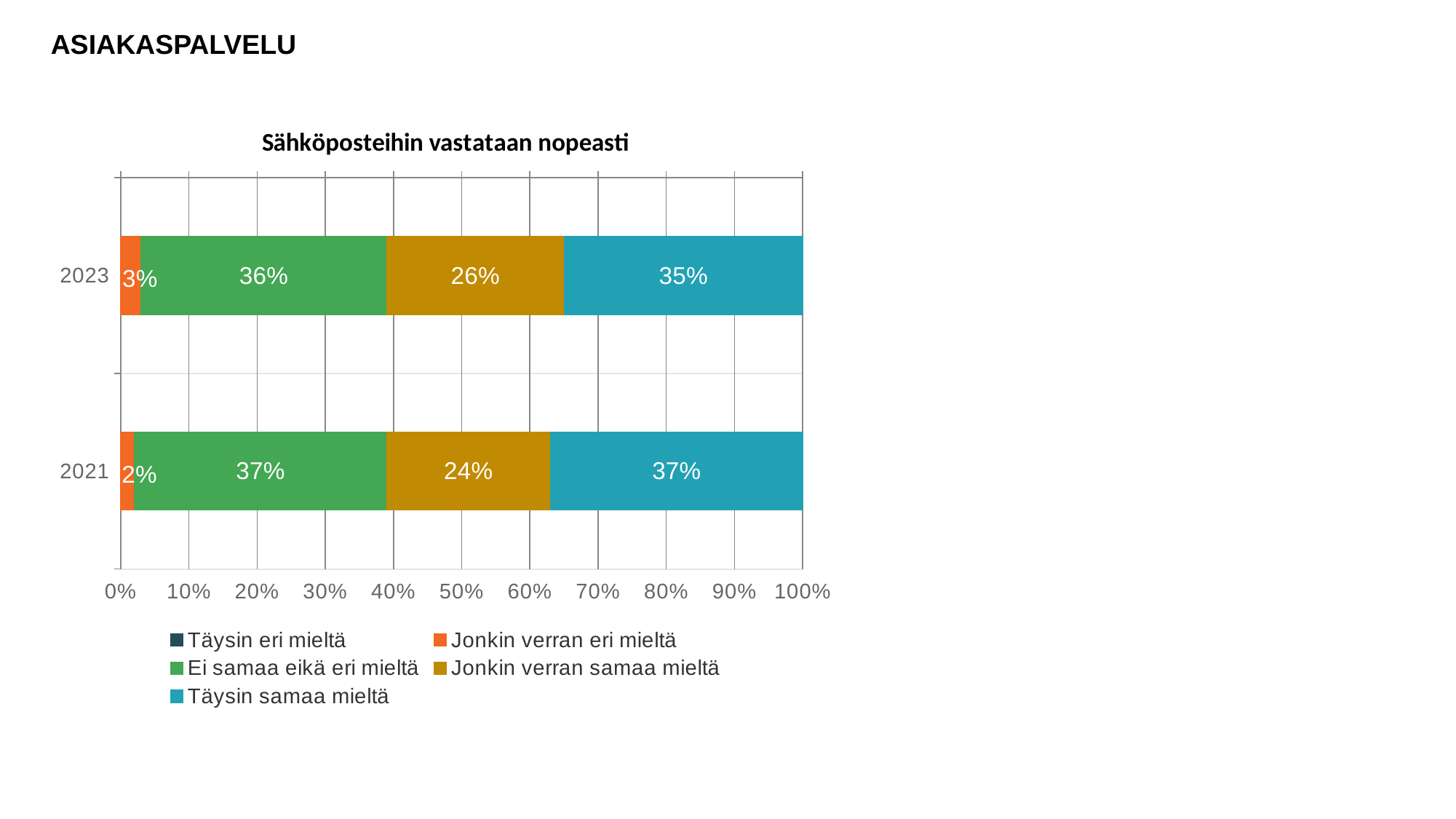
Which series has the smallest labelled value in the 2023 bar? Jonkin verran eri mieltä What is the value for "Ei samaa eikä eri mieltä" in 2023? 36% What is the value for "Täysin samaa mieltä" in 2021? 37% How many series does the legend list? 5 What is the title of the chart? Sähköposteihin vastataan nopeasti Which is larger: "Täysin samaa mieltä" in 2021 or "Täysin samaa mieltä" in 2023? 2021 How many years (categories) are shown on the chart? 2 What kind of chart is shown on the slide? Stacked bar chart What is the difference between the "Jonkin verran samaa mieltä" values for 2023 and 2021? 2% What is the value for "Jonkin verran eri mieltä" in 2021? 2% Which colour represents "Täysin samaa mieltä" in the legend? Teal (blue) What is the value for "Jonkin verran samaa mieltä" in 2023? 26%